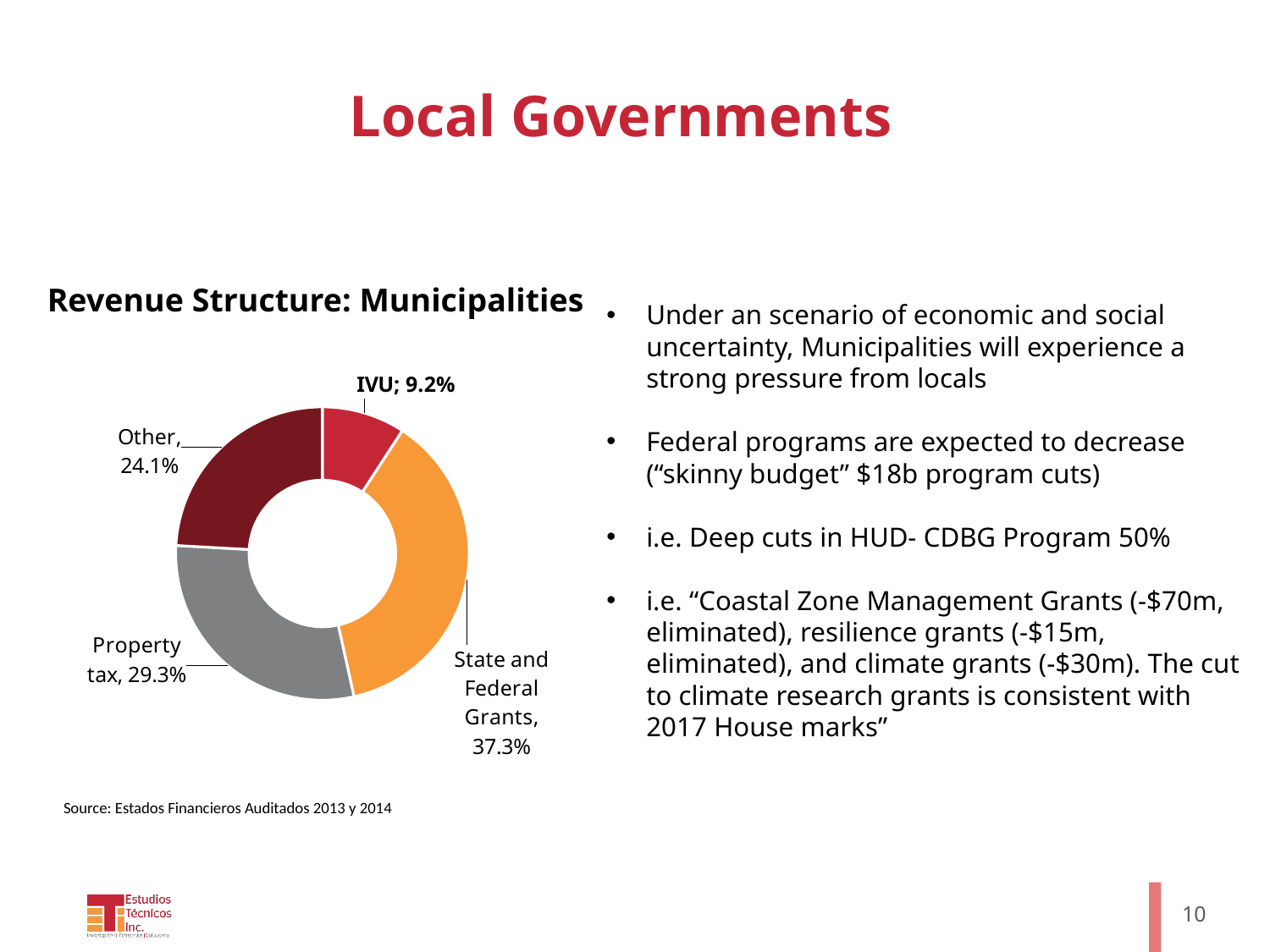
What share of municipal revenue comes from Property tax? 29.3% Which revenue source has the largest share in the Revenue Structure: Municipalities chart? State and Federal Grants What share of municipal revenue comes from State and Federal Grants? 37.3% What share of municipal revenue comes from IVU? 9.2% What is the difference in percentage points between State and Federal Grants and Property tax? 8 percentage points Which is larger, the share for Property tax or the share for Other? Property tax What share of municipal revenue is labelled Other? 24.1% What kind of chart is used to show the Revenue Structure: Municipalities? Doughnut (pie) chart What is the title of the chart on the slide? Revenue Structure: Municipalities How many revenue categories are shown in the chart? 4 Which revenue source has the smallest share in the Revenue Structure: Municipalities chart? IVU What is the difference in percentage points between Other and IVU? 14.9 percentage points